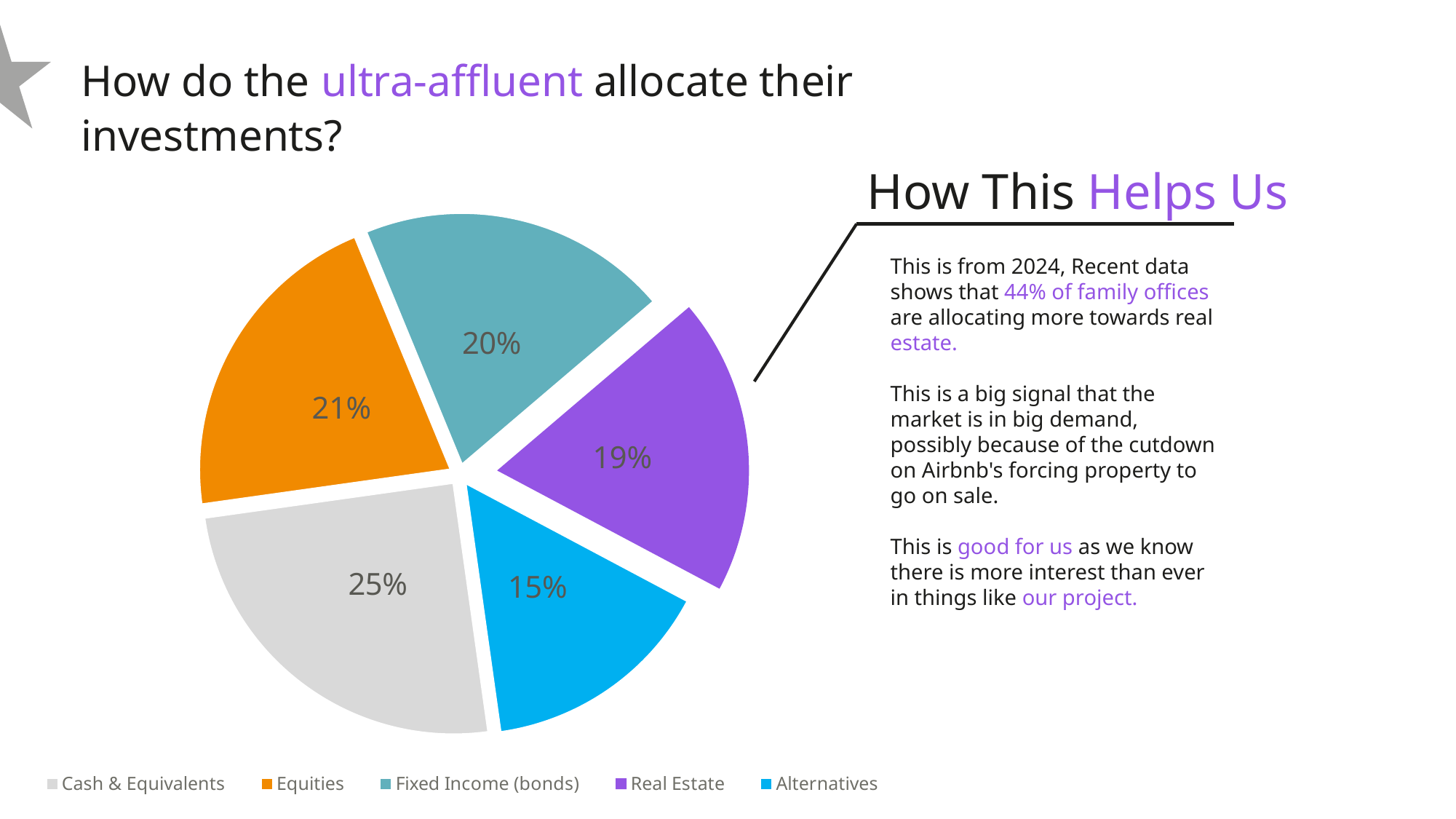
What share of investments is allocated to Cash & Equivalents? 25% What share of investments is allocated to Real Estate? 19% What is the difference in percentage points between Equities and Fixed Income (bonds)? 1 What kind of chart is shown on the slide? pie chart How many categories does the pie chart show? 5 Which colour represents Real Estate in the pie chart? purple Which category has the smallest share of the pie? Alternatives Which category has the largest share of the pie? Cash & Equivalents What share of investments is allocated to Fixed Income (bonds)? 20% What share of investments is allocated to Alternatives? 15% What is the difference in percentage points between Cash & Equivalents and Alternatives? 10 Which is larger, the share for Equities or the share for Real Estate? Equities